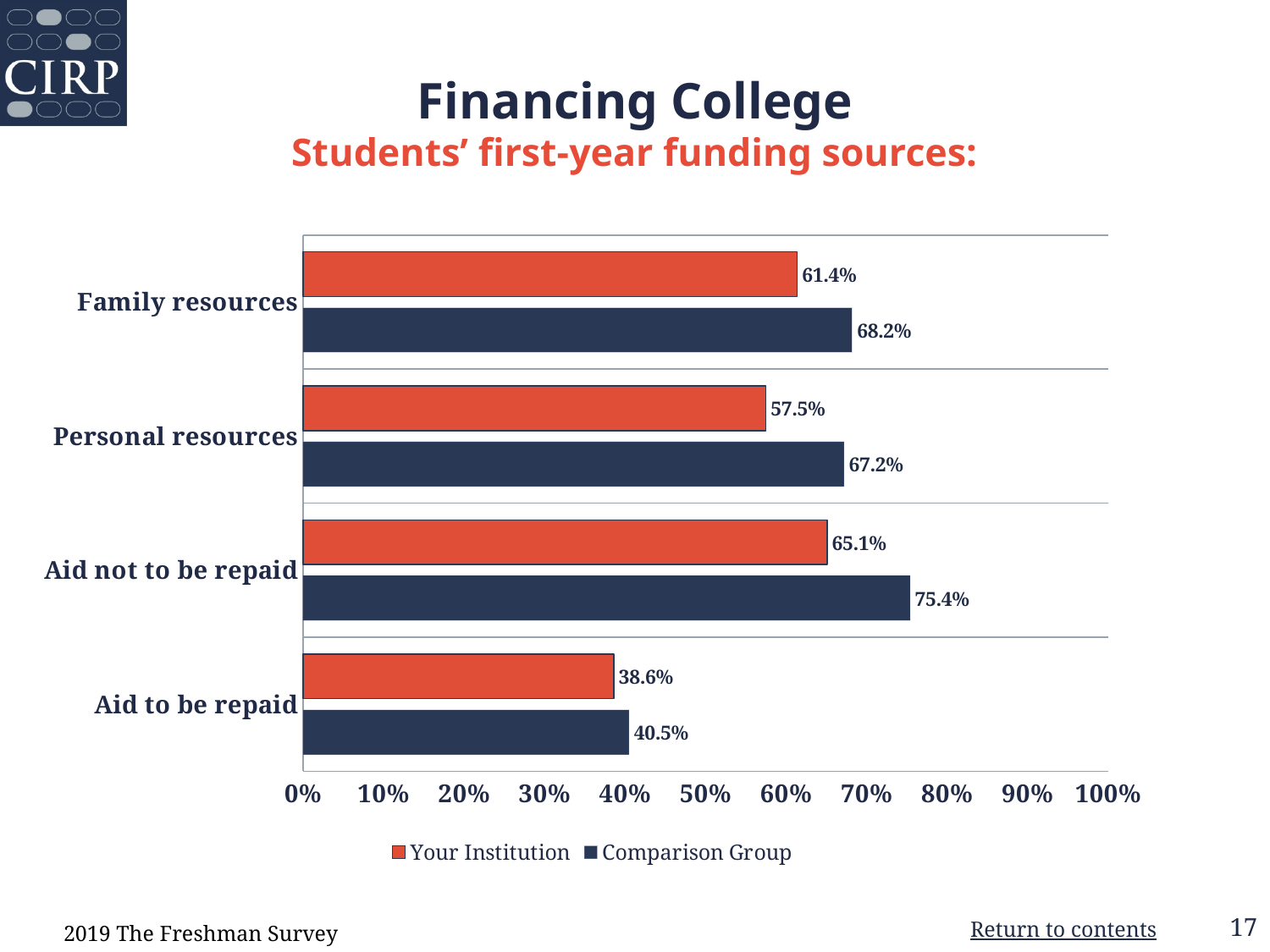
How many series does the legend list? 2 What is the value for Your Institution for Family resources? 61.4% What kind of chart is shown on the slide? Bar chart Which category has the highest value for the Comparison Group? Aid not to be repaid Which series is shown in dark blue in the legend? Comparison Group What is the value for Your Institution for Aid to be repaid? 38.6% Which category has the lowest value for Your Institution? Aid to be repaid Which is larger for Aid not to be repaid: Your Institution or Comparison Group? Comparison Group What is the value for Comparison Group for Aid not to be repaid? 75.4% What is the difference between the Comparison Group and Your Institution values for Personal resources? 9.7% How many funding source categories are shown in the chart? 4 Is the Comparison Group value for Aid to be repaid greater or less than 50%? less